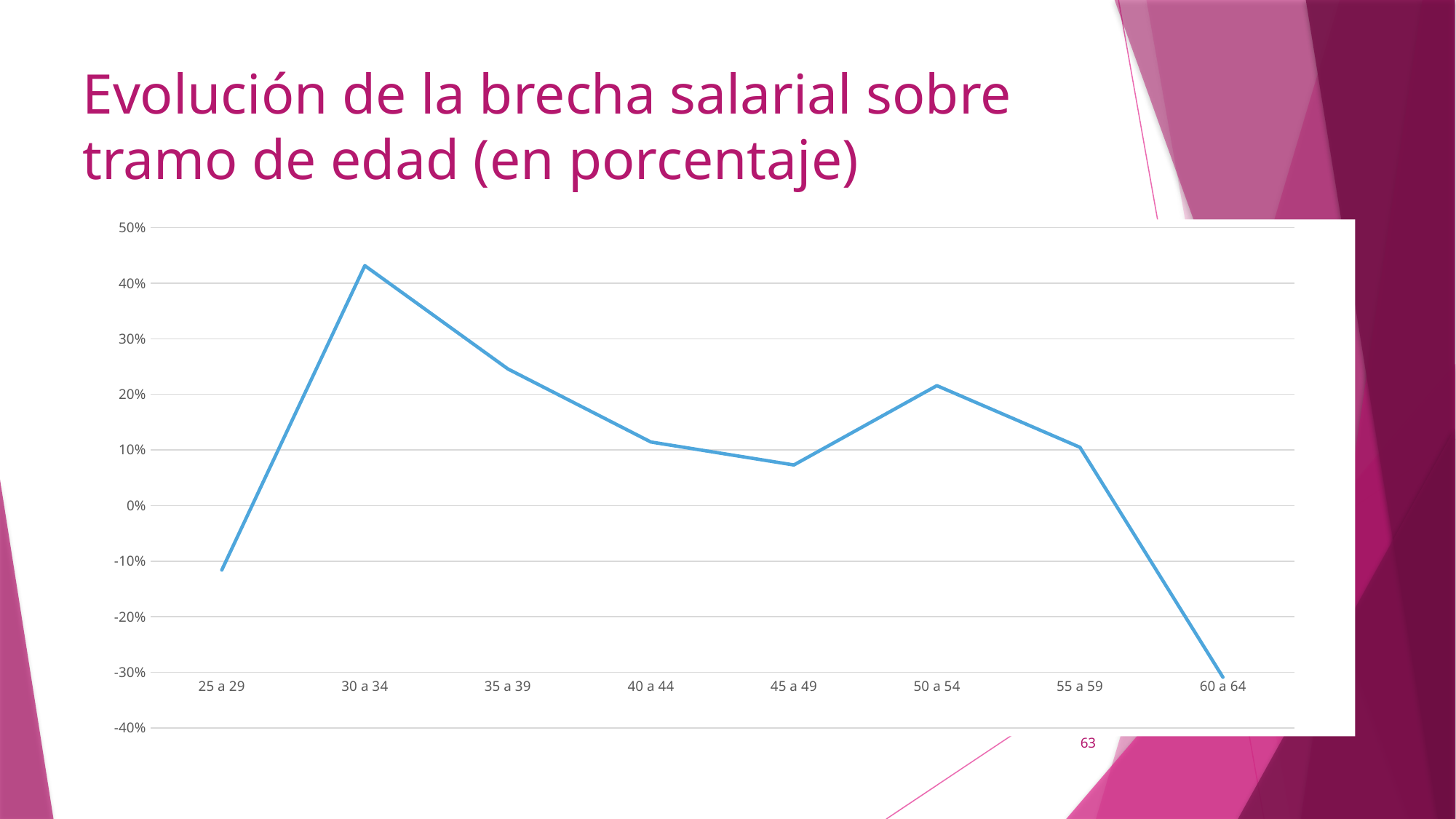
Is the value for 25 a 29 greater or less than 0%? less Which age group has the highest value? 30 a 34 Is the value for 35 a 39 greater or less than 20%? greater Does the line rise or fall from 30 a 34 to 45 a 49? Falls Which age group has the lowest value? 60 a 64 How many age groups are plotted along the x axis? 8 Is the value for 60 a 64 greater or less than -20%? less Which has the larger value, 30 a 34 or 50 a 54? 30 a 34 What is the title of the chart on the slide? Evolución de la brecha salarial sobre tramo de edad (en porcentaje) What kind of chart is shown on the slide? Line chart